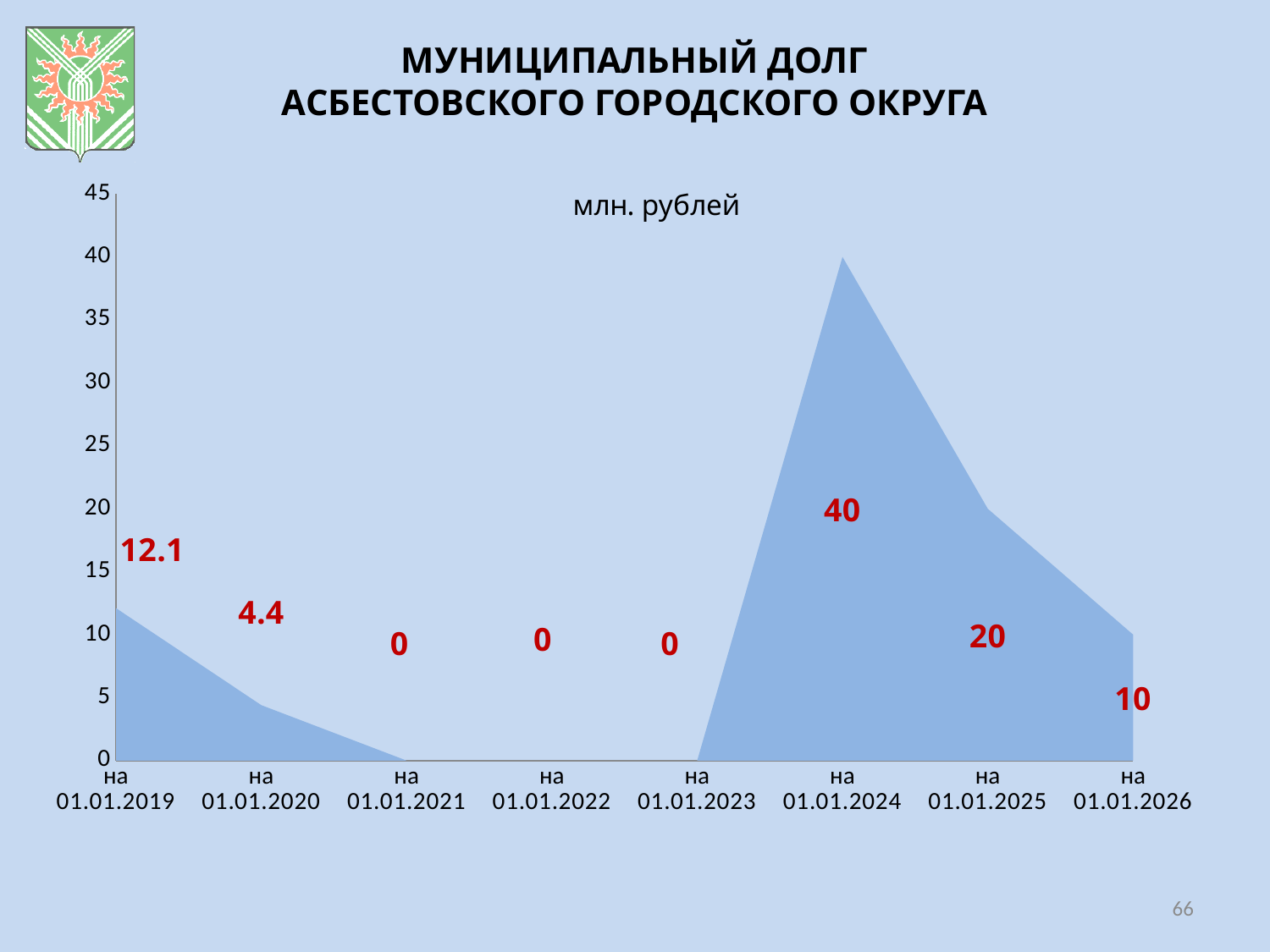
How many dates are plotted on the x axis? 8 What kind of chart is shown on the slide? area chart What is the difference between the debt on 01.01.2019 and on 01.01.2020? 7.7 What is the municipal debt value shown for 01.01.2019? 12.1 On which date is the municipal debt highest? 01.01.2024 Which is larger, the debt on 01.01.2019 or on 01.01.2026? 01.01.2019 What is the difference between the debt on 01.01.2024 and on 01.01.2025? 20 In what units are the values on the chart expressed? млн. рублей What is the municipal debt value shown for 01.01.2024? 40 What is the municipal debt value shown for 01.01.2020? 4.4 What is the municipal debt value shown for 01.01.2026? 10 How many dates show a debt value of 0? 3